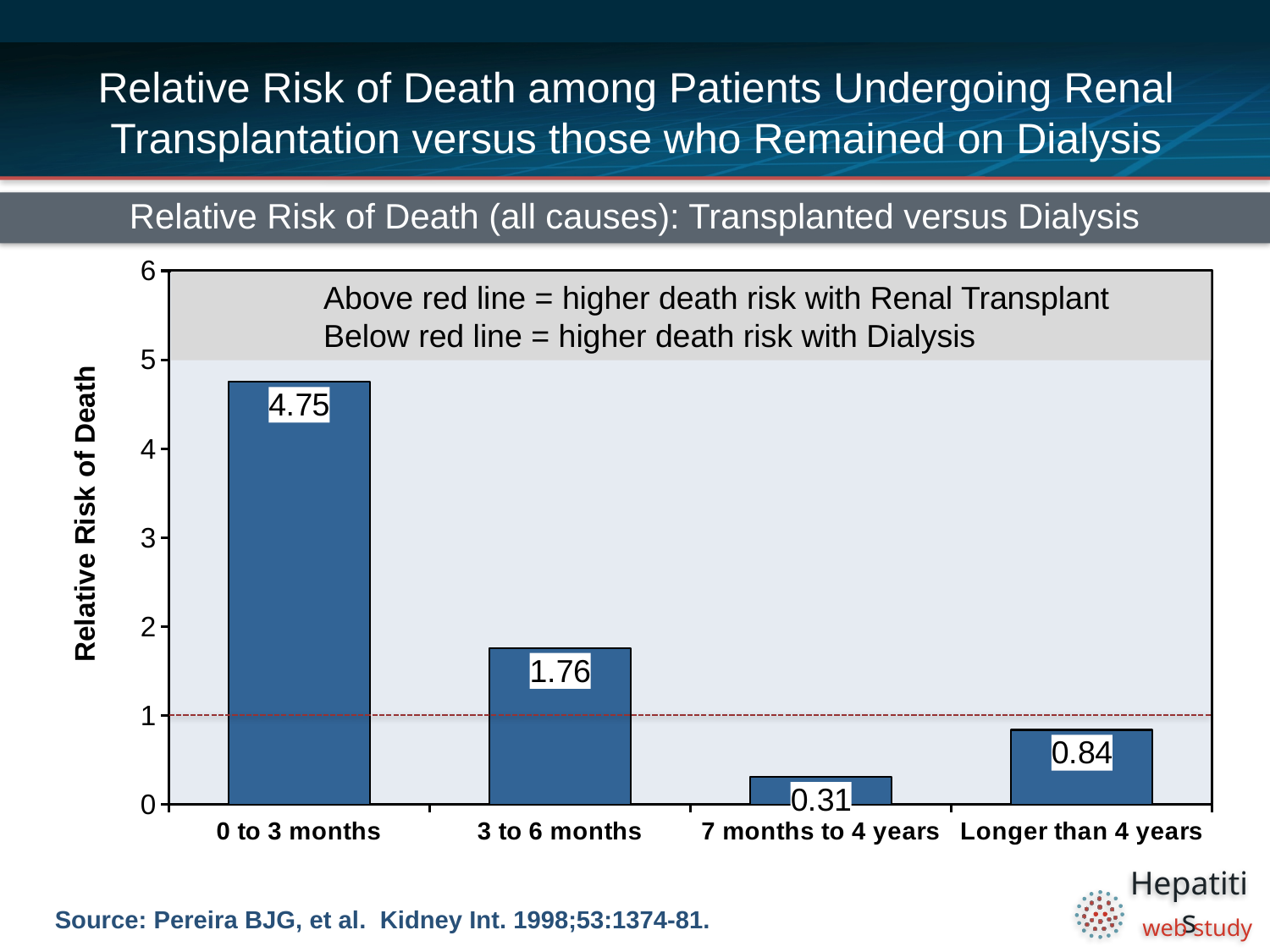
What is the relative risk of death for the 0 to 3 months category? 4.75 What is the relative risk of death for the Longer than 4 years category? 0.84 How many time-period categories are shown on the x axis? 4 What is the difference in relative risk of death between the 0 to 3 months and 3 to 6 months categories? 2.99 Is the relative risk of death for 3 to 6 months greater or less than 1? greater What kind of chart is shown on the slide? Bar chart What is the relative risk of death for the 7 months to 4 years category? 0.31 What is the label of the y axis? Relative Risk of Death Which has a larger relative risk of death: Longer than 4 years or 7 months to 4 years? Longer than 4 years Which category has the highest relative risk of death? 0 to 3 months Which category has the lowest relative risk of death? 7 months to 4 years What is the relative risk of death for the 3 to 6 months category? 1.76